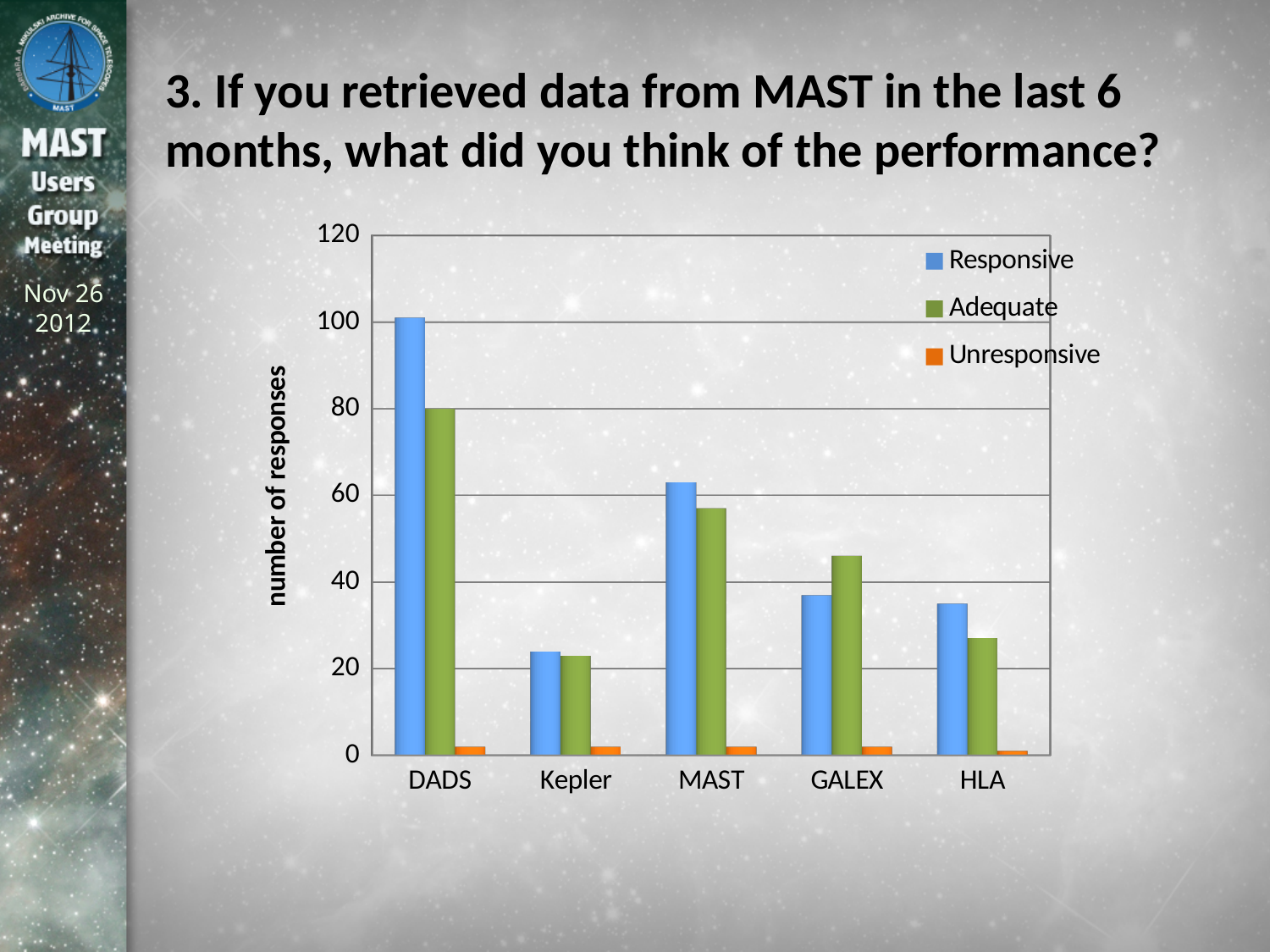
Is the Adequate value for GALEX greater or less than 40? greater Which category has the highest Responsive value? DADS Is the Responsive value for Kepler greater or less than 40? less How many series does the legend list? 3 For GALEX, which is larger: the Responsive value or the Adequate value? Adequate What kind of chart is shown on the slide? bar chart How many categories are shown along the x axis? 5 Is the Responsive value for DADS greater or less than 80? greater What is the label of the y axis? number of responses For DADS, which is larger: the Responsive value or the Adequate value? Responsive Which category has the lowest Responsive value? Kepler Which category has the highest Adequate value? DADS